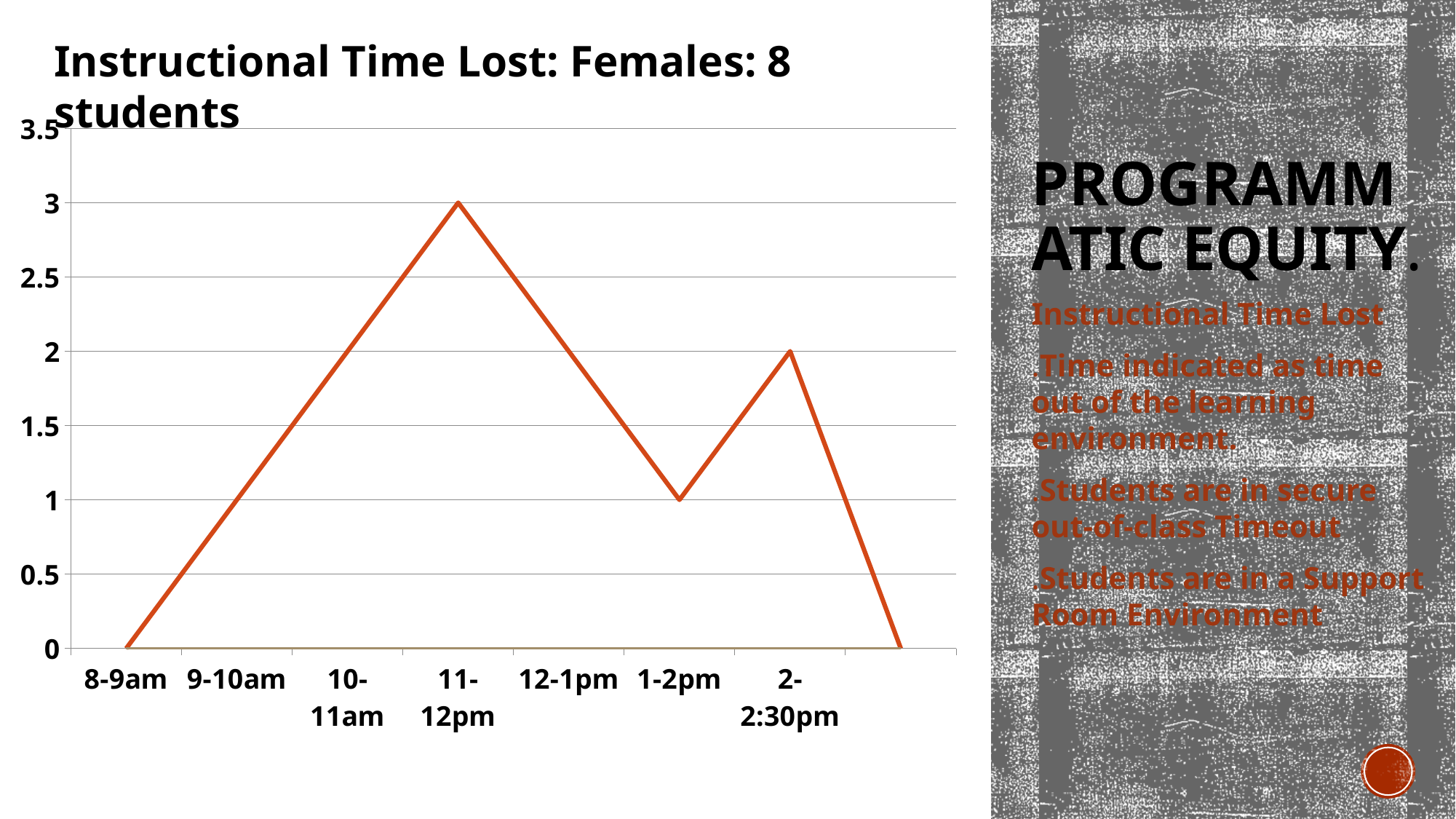
What is the title of the chart? Instructional Time Lost: Females: 8 students What is the value for 2-2:30pm? 2 Which is larger, the value for 12-1pm or the value for 1-2pm? 12-1pm What is the value for 11-12pm? 3 What is the value for 8-9am? 0 What is the value for 1-2pm? 1 Is the value for 10-11am greater or less than 1.5? greater What kind of chart is shown on the slide? line chart What is the value for 9-10am? 1 Do the values rise or fall from 11-12pm to 1-2pm? fall What is the difference between the values for 11-12pm and 1-2pm? 2 Which time slot has the highest value? 11-12pm